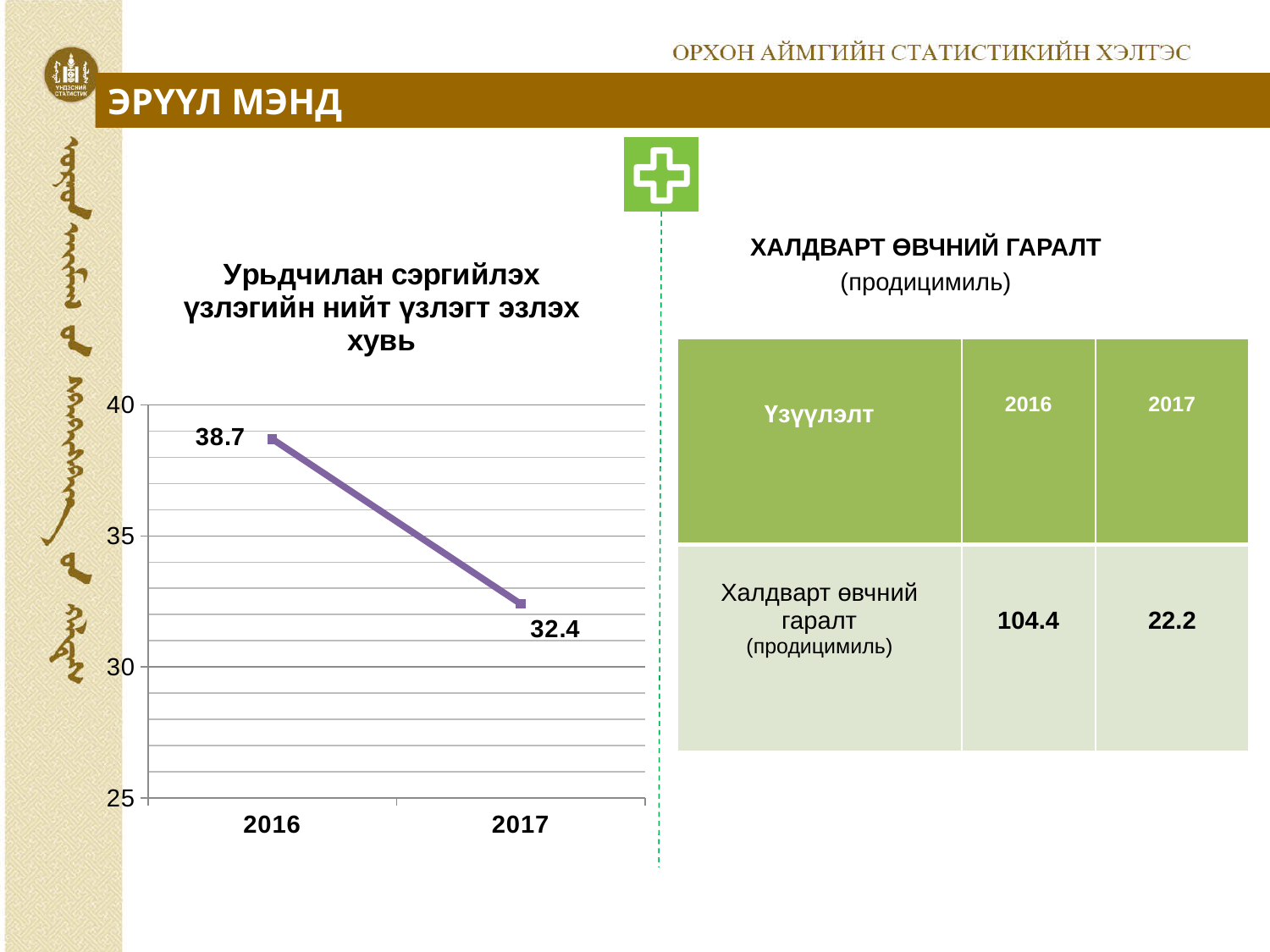
Which year has the lower value in the line chart? 2017 Is the value for 2017 greater or less than 35 in the line chart? less How many data points are plotted in the line chart? 2 What is the value for 2017 in the line chart? 32.4 What kind of chart is shown on the slide? line chart What is the difference between the 2016 and 2017 values in the line chart? 6.3 Which year has the higher value in the line chart? 2016 What is the value for 2016 in the line chart? 38.7 Do the values in the line chart rise or fall from 2016 to 2017? fall Is the value for 2016 larger or smaller than the value for 2017 in the line chart? larger What is the title of the line chart? Урьдчилан сэргийлэх үзлэгийн нийт үзлэгт эзлэх хувь Is the value for 2016 greater or less than 35 in the line chart? greater